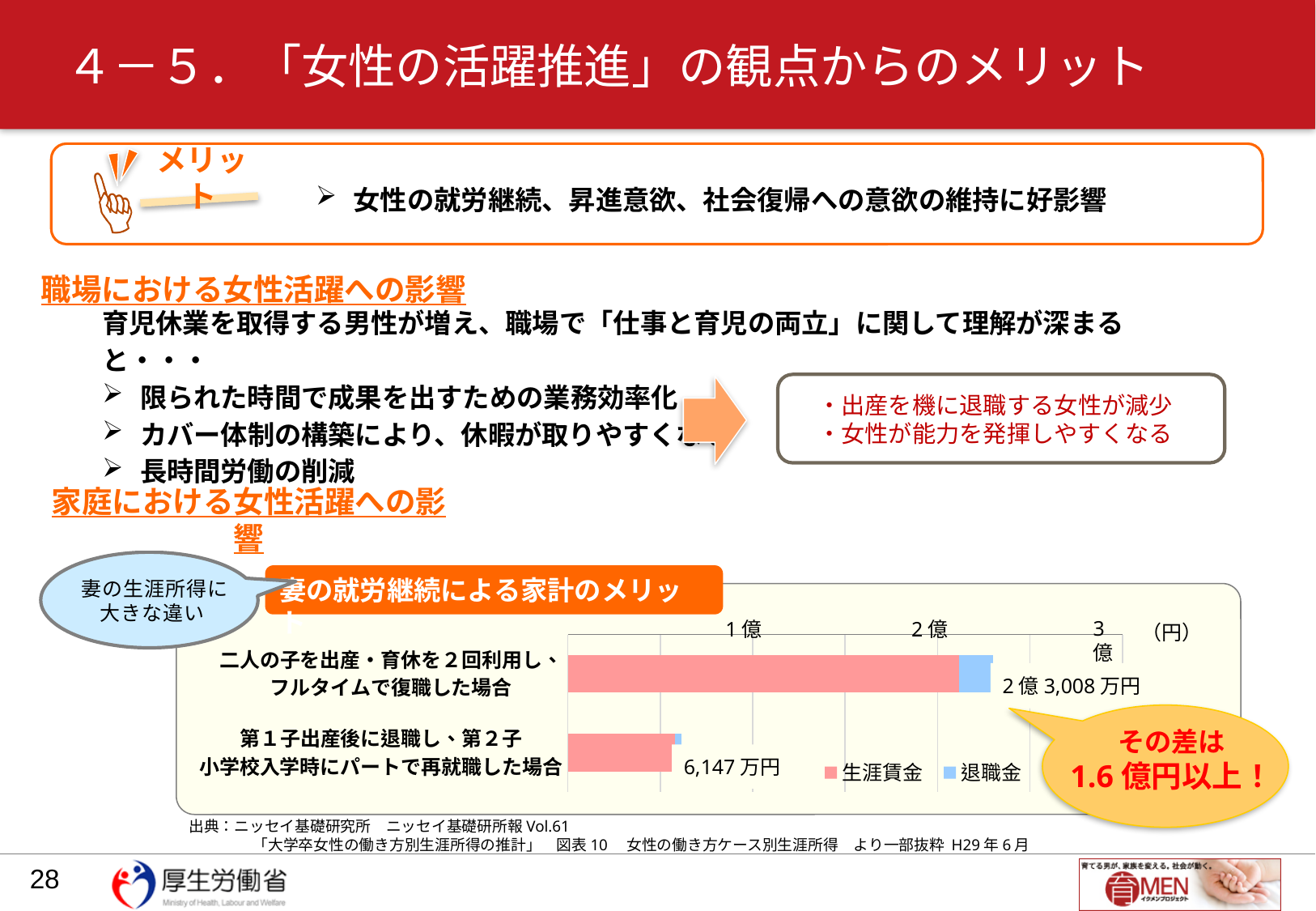
Which category has the higher total value? 二人の子を出産・育休を２回利用し、フルタイムで復職した場合 What are the two series listed in the chart's legend? 生涯賃金, 退職金 Is the total for 「第１子出産後に退職し、第２子小学校入学時にパートで再就職した場合」 greater or less than 1億? less How many categories does the chart show? 2 What is the total value labelled for 「第１子出産後に退職し、第２子小学校入学時にパートで再就職した場合」? 6,147万円 Which series is shown in pink in the chart? 生涯賃金 What kind of chart is shown on the slide? bar chart Which category has the lower total value? 第１子出産後に退職し、第２子小学校入学時にパートで再就職した場合 Is the total for 「二人の子を出産・育休を２回利用し、フルタイムで復職した場合」 greater or less than 2億? greater What is the total value labelled for 「二人の子を出産・育休を２回利用し、フルタイムで復職した場合」? 2億3,008万円 How many series does the chart's legend list? 2 What unit is shown next to the chart's axis? 円